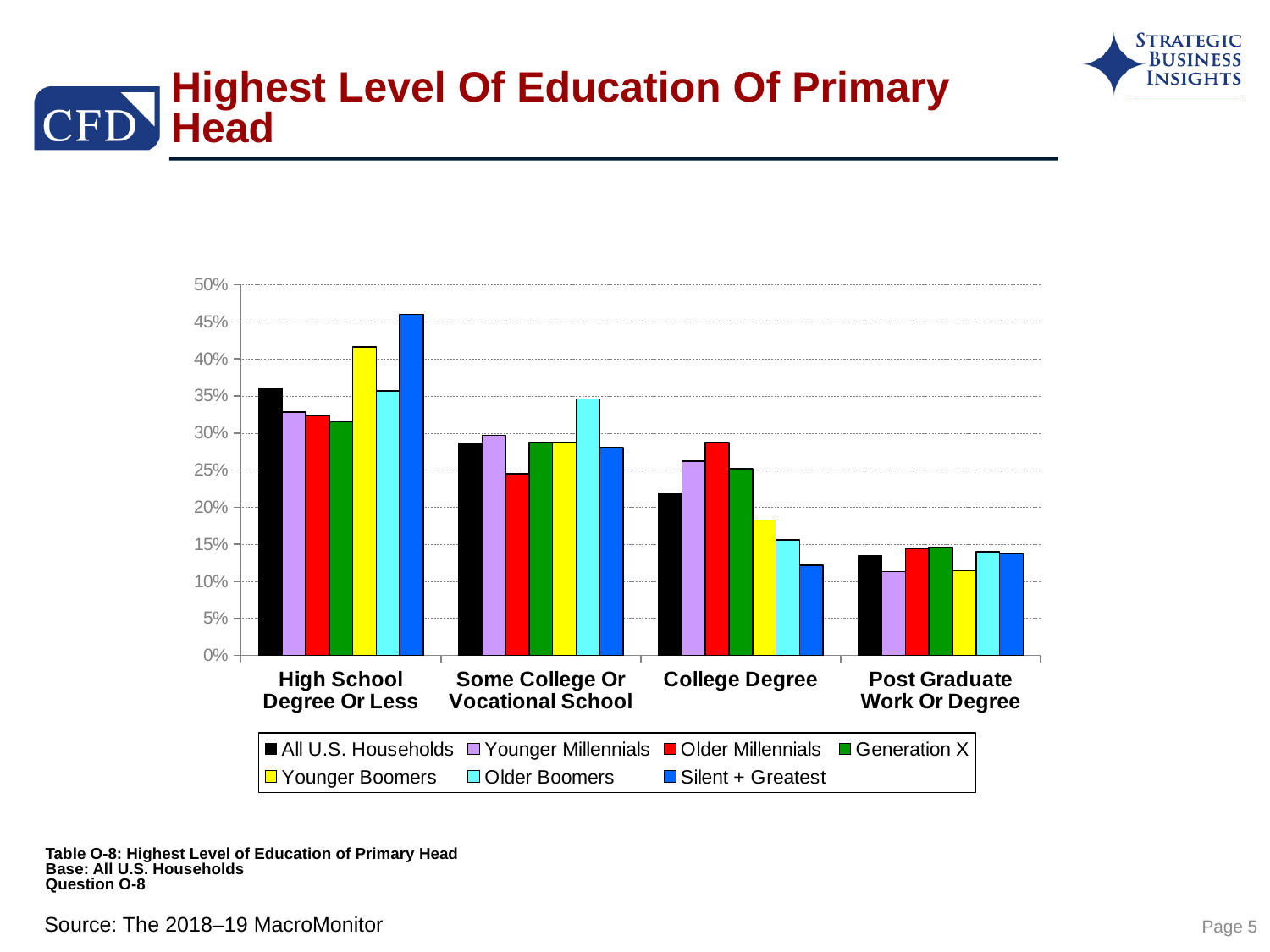
What colour represents Older Millennials in the legend? red In the College Degree category, which series has the lowest value? Silent + Greatest Is the value for All U.S. Households in the College Degree category greater or less than 25%? less Do the values for Younger Boomers rise or fall moving from High School Degree Or Less to Post Graduate Work Or Degree? fall How many education-level categories are shown on the x axis? 4 In the High School Degree Or Less category, which series has the highest value? Silent + Greatest In the College Degree category, which series has the highest value? Older Millennials In the College Degree category, which is larger: Older Millennials or Younger Boomers? Older Millennials Is the value for Silent + Greatest in the High School Degree Or Less category greater or less than 40%? greater How many series does the legend list? 7 In the Some College Or Vocational School category, which series has the highest value? Older Boomers What kind of chart is shown on the slide? bar chart